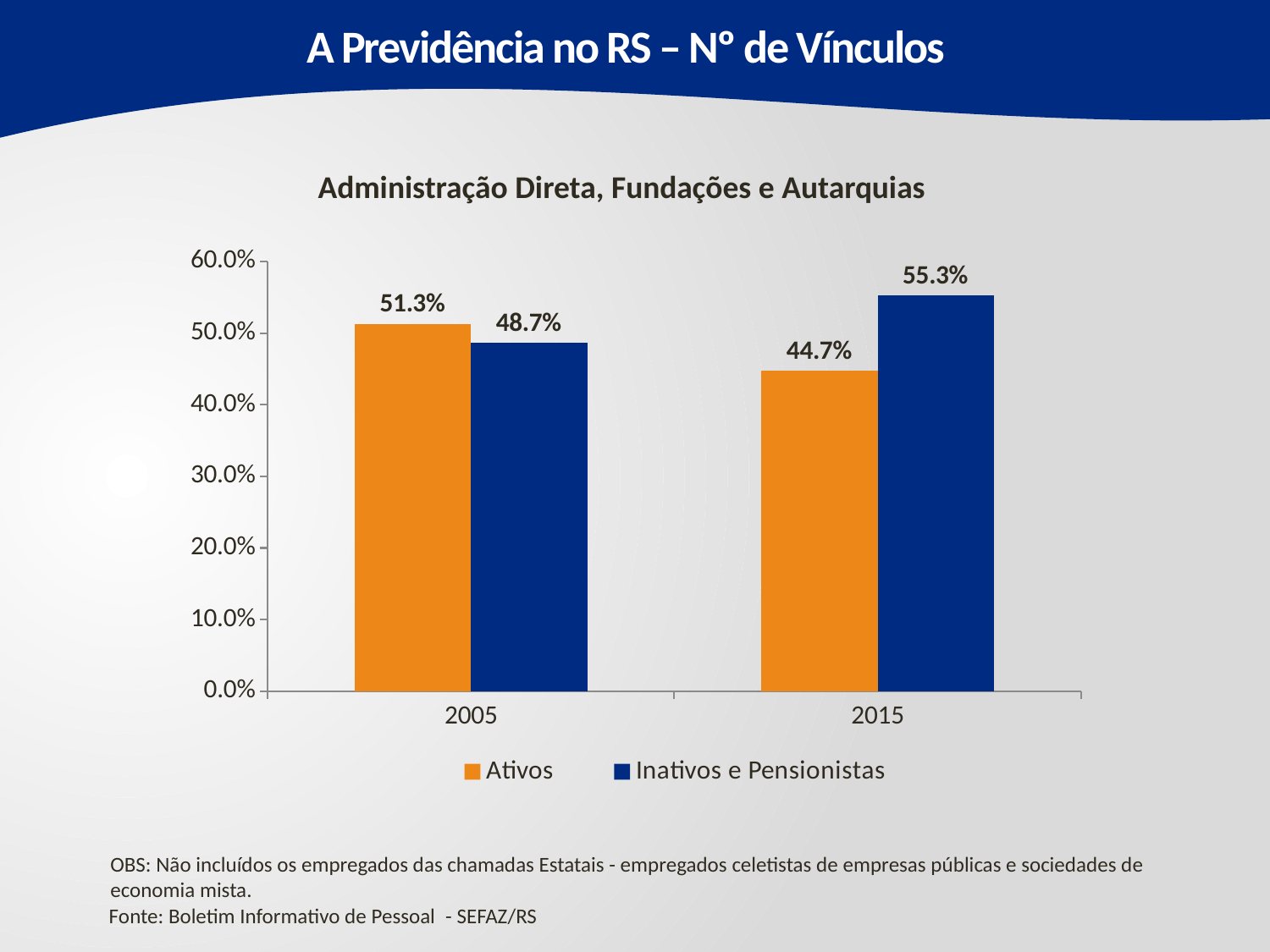
What is the difference between Inativos e Pensionistas and Ativos in 2015? 10.6% What kind of chart is shown on the slide? Bar chart Which series has the highest value in 2015? Inativos e Pensionistas What is the value for Ativos in 2005? 51.3% What is the value for Ativos in 2015? 44.7% How many series does the legend list? 2 Is the value for Ativos in 2005 larger than the value for Ativos in 2015? Yes Which series has the lowest value in 2005? Inativos e Pensionistas Is the value for Inativos e Pensionistas in 2015 greater or less than 50.0%? greater Does the value for Ativos rise or fall from 2005 to 2015? Fall What is the value for Inativos e Pensionistas in 2005? 48.7% What is the value for Inativos e Pensionistas in 2015? 55.3%